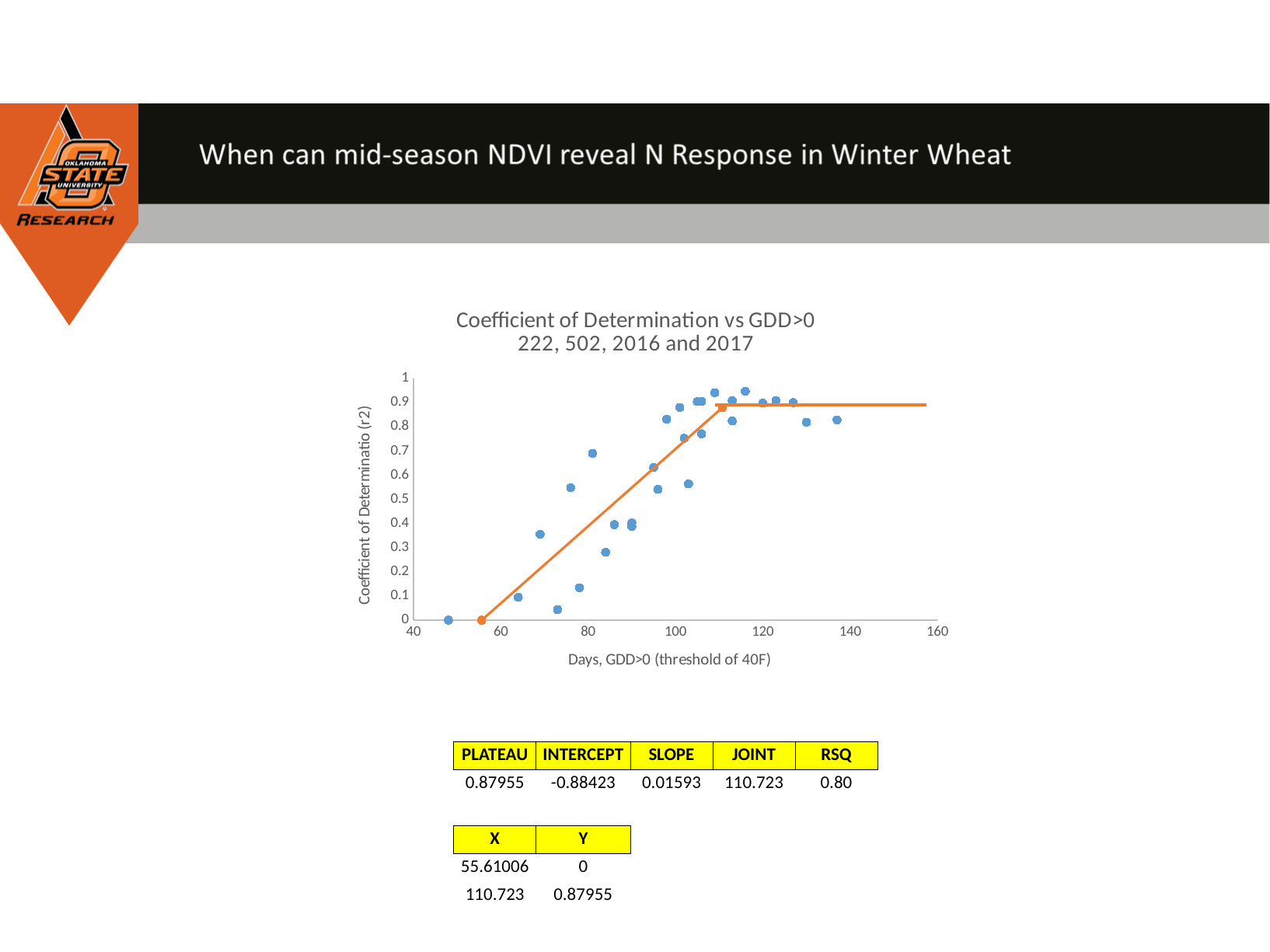
What is the plateau value of the fitted orange line shown in the table below the chart? 0.87955 Do the coefficient of determination values generally rise or fall as Days, GDD>0 increases from 40 to 110? rise What is the label of the x axis of the chart? Days, GDD>0 (threshold of 40F) Is the highest blue data point on the chart greater or less than 0.9? greater What is the x value at which the fitted orange line starts at y = 0? 55.61006 What is the RSQ value reported for the fitted line? 0.80 What kind of chart is shown on the slide? scatter chart Is the plateau level of the orange fitted line greater or less than 0.8? greater Is the x value of the leftmost blue data point greater or less than 60? less At what x value (JOINT) does the fitted orange line reach its plateau? 110.723 What is the title of the chart? Coefficient of Determination vs GDD>0 222, 502, 2016 and 2017 What is the slope of the fitted line reported in the table? 0.01593